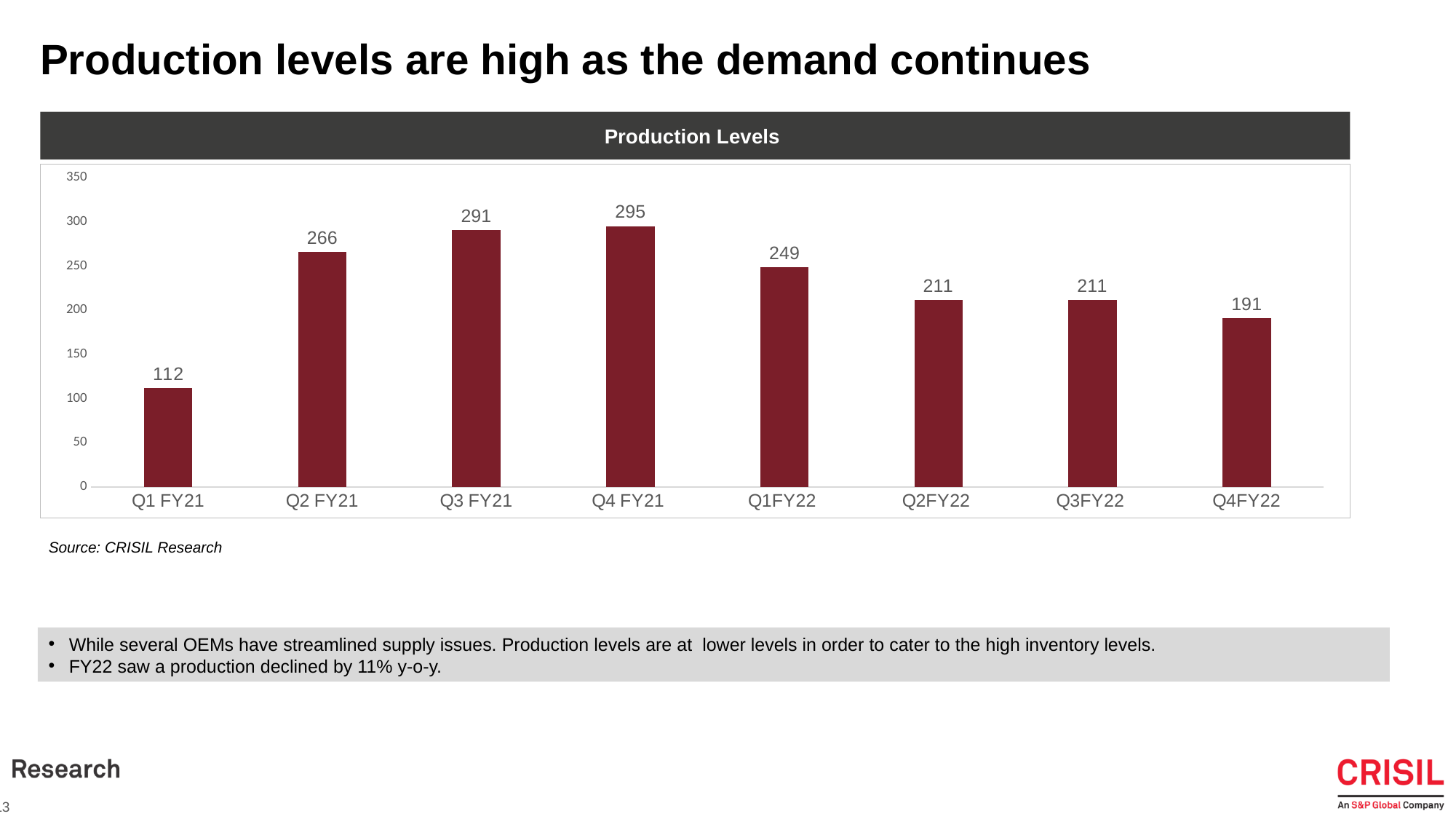
Which is larger, the production level for Q3 FY21 or for Q1FY22? Q3 FY21 What is the difference between the production levels of Q4 FY21 and Q1FY22? 46 How many quarters are shown on the chart? 8 Which quarter has the lowest production level? Q1 FY21 Which quarter has the highest production level? Q4 FY21 What is the title of the chart? Production Levels What is the production level for Q4 FY21? 295 Is the production level for Q2FY22 greater or less than 250? less What kind of chart is shown on the slide? bar chart What is the production level for Q1 FY21? 112 What is the production level for Q4FY22? 191 What is the difference between the production levels of Q2 FY21 and Q1 FY21? 154